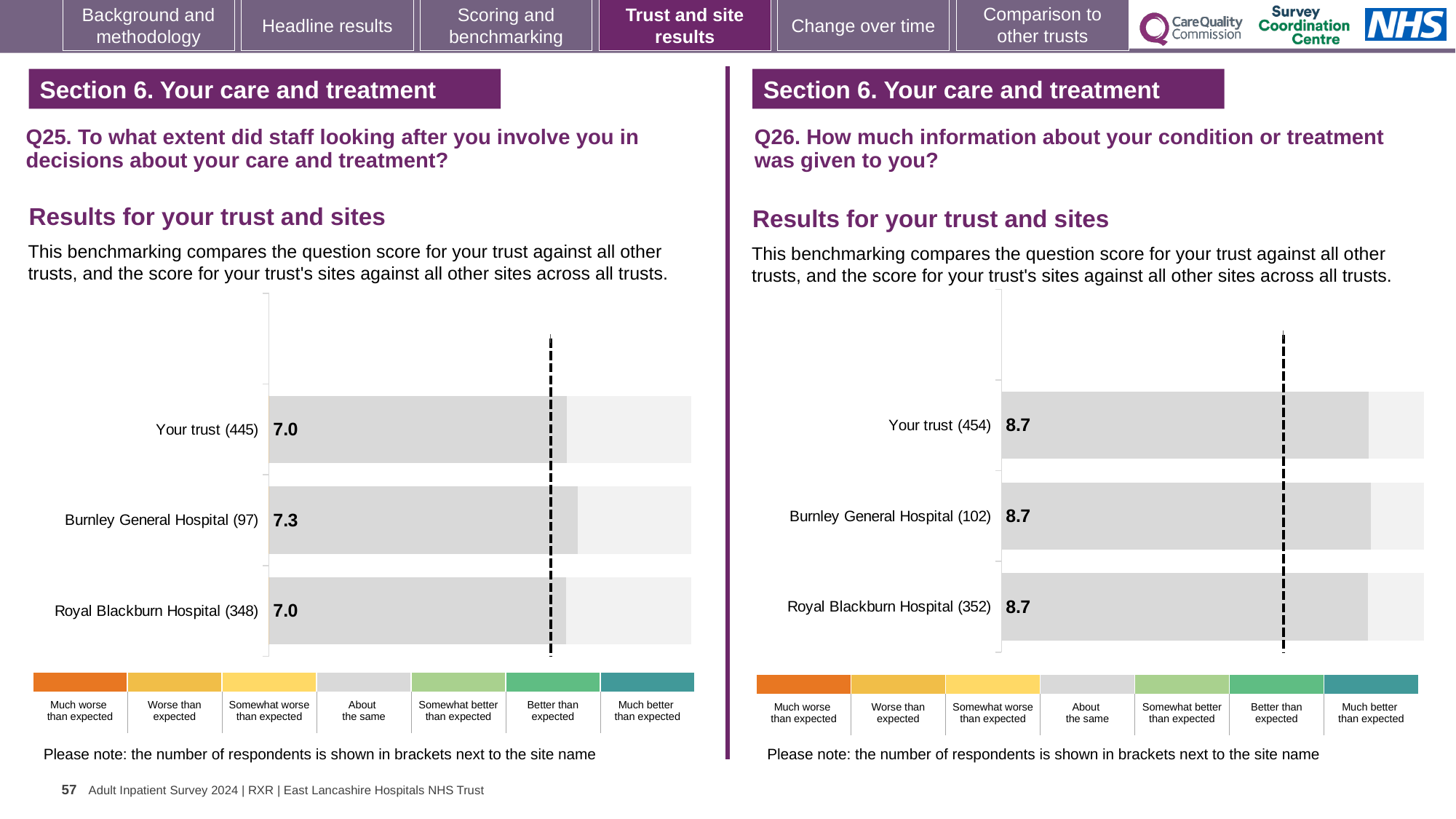
In the Q25 chart on the left, what is the score for Your trust? 7.0 In the Q25 chart on the left, what is the score for Royal Blackburn Hospital? 7.0 Which is larger: the Q25 score for Your trust or the Q26 score for Your trust? Q26 score for Your trust In the Q25 chart on the left, how many respondents are shown in brackets for Royal Blackburn Hospital? 348 What kind of chart is used in the Q25 chart on the left? Bar chart In the Q26 chart on the right, what is the score for Burnley General Hospital? 8.7 In the Q26 chart on the right, how many bars are plotted? 3 In the Q25 chart on the left, what is the score for Burnley General Hospital? 7.3 In the Q26 chart on the right, what is the score for Your trust? 8.7 In the Q25 chart on the left, what is the difference between the scores for Burnley General Hospital and Royal Blackburn Hospital? 0.3 In the Q25 chart on the left, which site has the highest score? Burnley General Hospital In the Q26 chart on the right, how many respondents are shown in brackets for Your trust? 454